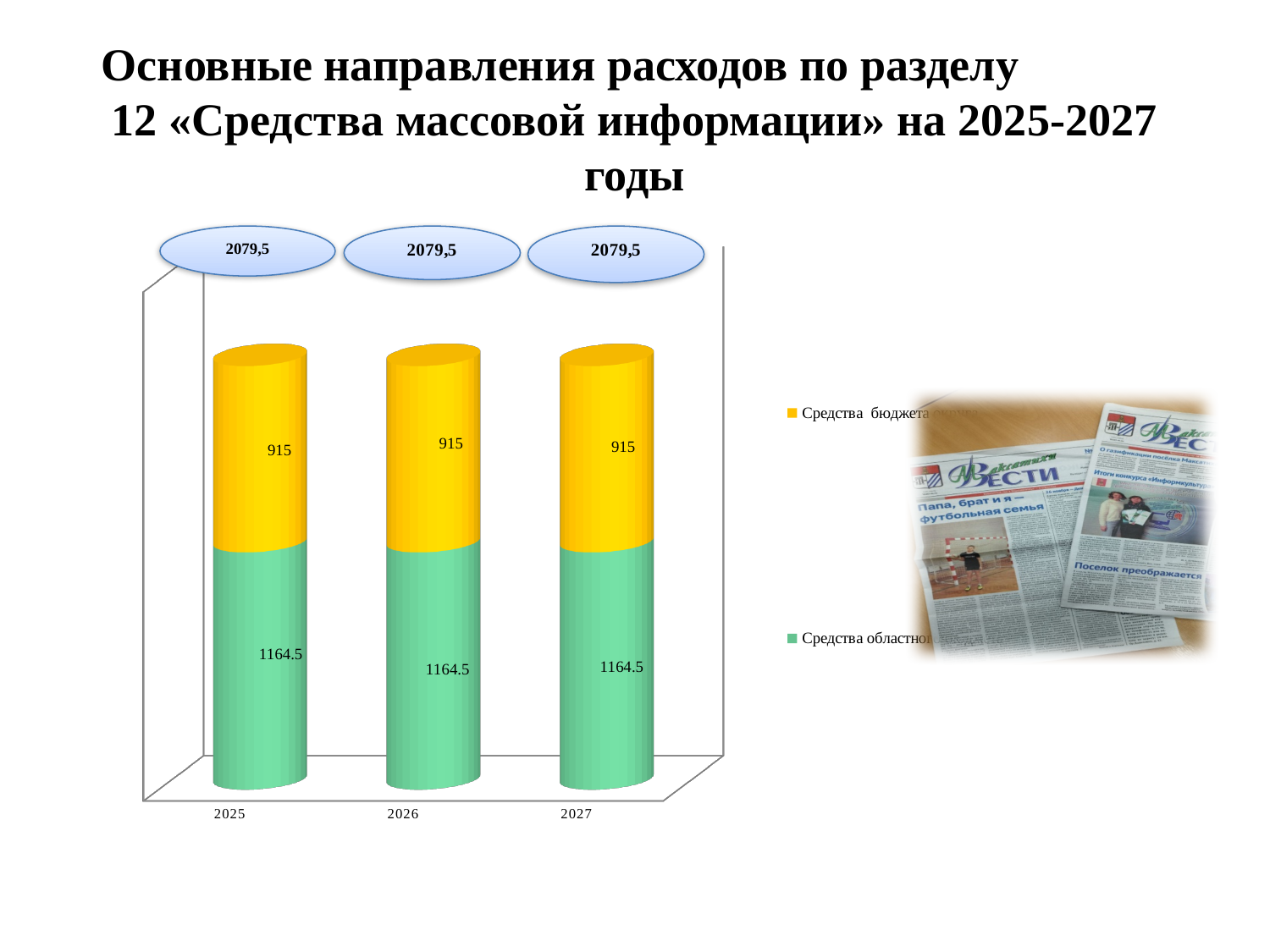
In 2025, which segment is larger, the green one or the yellow one? green Which colour represents the series "Средства бюджета..." in the legend? yellow What is the total of the stacked bar for 2027? 2079,5 How many years are shown on the x axis of the chart? 3 What is the value of the yellow segment for 2025? 915 What is the total of the stacked bar for 2025, as shown in the oval above it? 2079,5 What kind of chart is shown on the slide? stacked bar chart What is the value of the yellow segment for 2027? 915 Do the values of the green segment rise, fall or stay the same from 2025 to 2027? stay the same What is the value of the green segment for 2026? 1164.5 What is the difference between the green segment and the yellow segment for 2027? 249.5 How many series does the legend list? 2